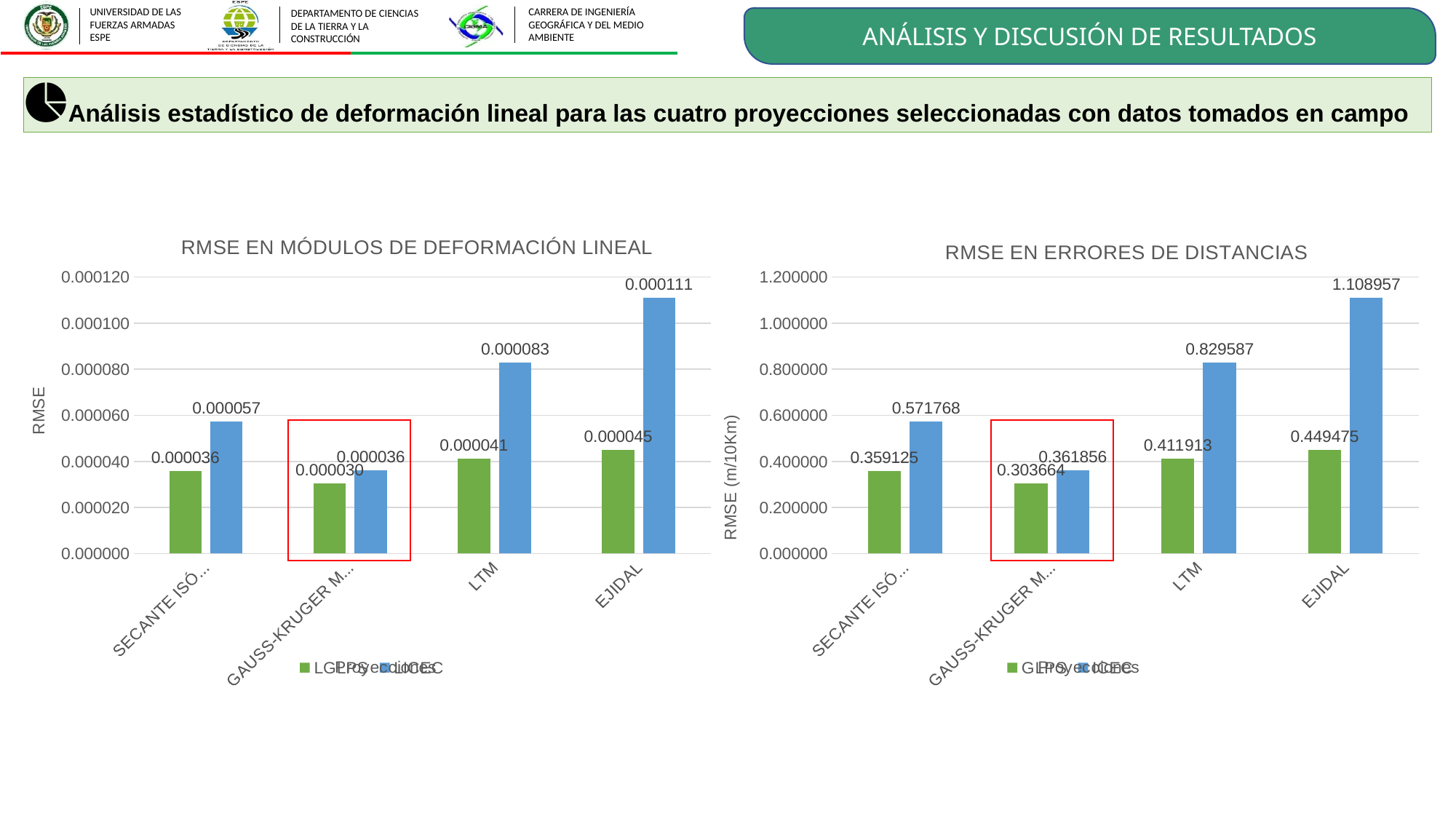
What type of chart is the chart titled 'RMSE EN ERRORES DE DISTANCIAS'? Bar chart In the chart titled 'RMSE EN MÓDULOS DE DEFORMACIÓN LINEAL', what is the difference between the blue bar for EJIDAL and the blue bar for LTM? 0.000028 In the chart titled 'RMSE EN ERRORES DE DISTANCIAS', what is the value of the green bar for EJIDAL? 0.449475 In the chart titled 'RMSE EN MÓDULOS DE DEFORMACIÓN LINEAL', what is the value of the green bar for LTM? 0.000041 In the chart titled 'RMSE EN MÓDULOS DE DEFORMACIÓN LINEAL', how many categories are shown on the x axis? 4 In the chart titled 'RMSE EN ERRORES DE DISTANCIAS', which category has the highest blue bar? EJIDAL What is the y-axis title of the chart titled 'RMSE EN ERRORES DE DISTANCIAS'? RMSE (m/10Km) In the chart titled 'RMSE EN ERRORES DE DISTANCIAS', what is the difference between the blue bar and the green bar for EJIDAL? 0.659482 In the chart titled 'RMSE EN ERRORES DE DISTANCIAS', what is the value of the blue bar for LTM? 0.829587 In the chart titled 'RMSE EN ERRORES DE DISTANCIAS', is the blue bar for EJIDAL greater or less than 1.000000? greater In the chart titled 'RMSE EN MÓDULOS DE DEFORMACIÓN LINEAL', which is larger: the green bar for LTM or the green bar for EJIDAL? EJIDAL In the chart titled 'RMSE EN MÓDULOS DE DEFORMACIÓN LINEAL', what is the value of the blue bar for EJIDAL? 0.000111